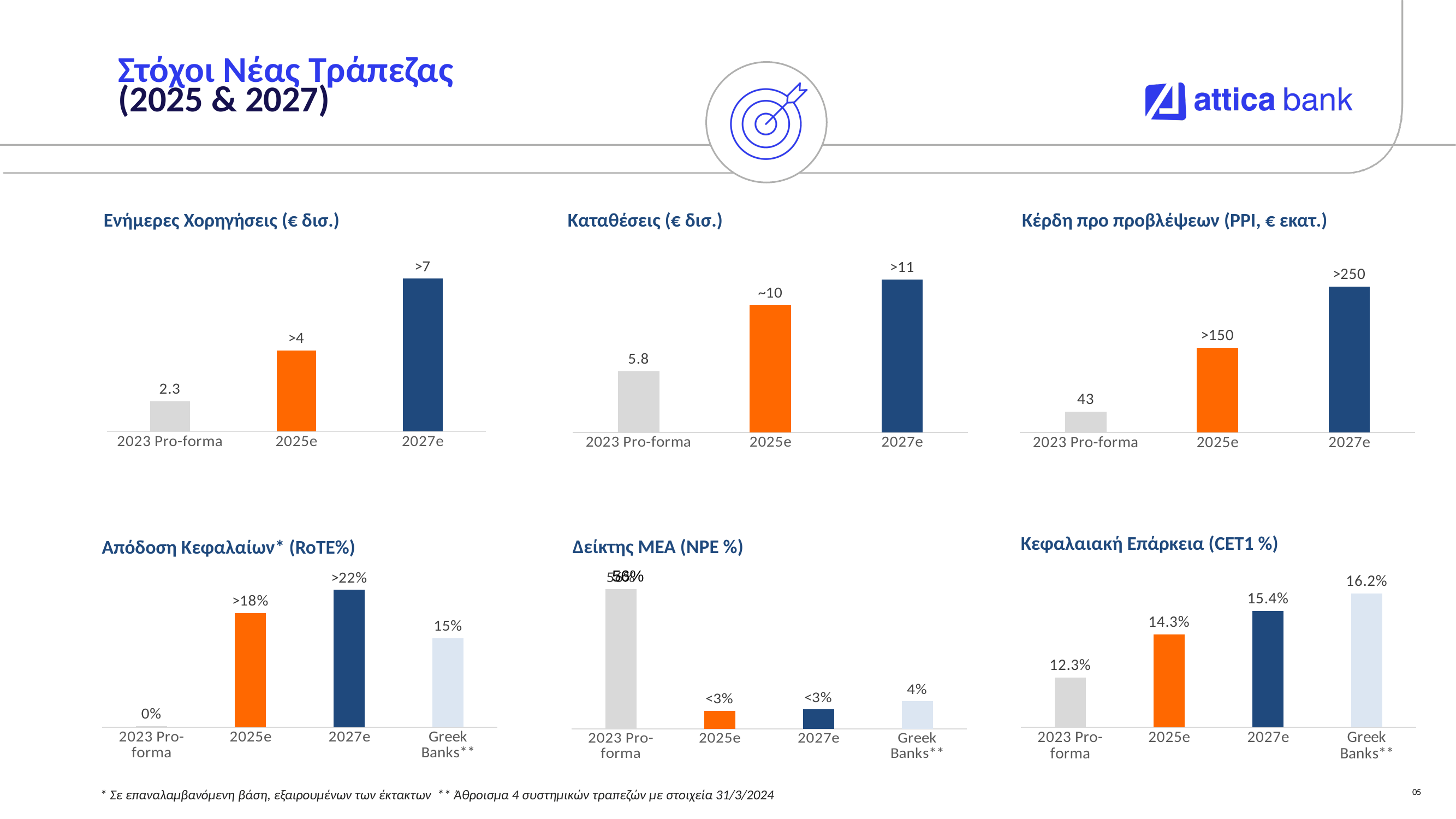
In the Κεφαλαιακή Επάρκεια (CET1 %) chart, what is the difference between Greek Banks** and 2023 Pro-forma? 3.9 percentage points In the Ενήμερες Χορηγήσεις (€ δισ.) chart, what is the value for 2023 Pro-forma? 2.3 In the Απόδοση Κεφαλαίων* (RoTE%) chart, which category has the lowest value? 2023 Pro-forma How many categories does the Κεφαλαιακή Επάρκεια (CET1 %) chart show? 4 In the Κέρδη προ προβλέψεων (PPI, € εκατ.) chart, what is the data label for 2025e? >150 In the Κεφαλαιακή Επάρκεια (CET1 %) chart, what is the value for 2027e? 15.4% In the Δείκτης ΜΕΑ (NPE %) chart, what is the value for Greek Banks**? 4% In the Καταθέσεις (€ δισ.) chart, what is the value for 2023 Pro-forma? 5.8 In the Ενήμερες Χορηγήσεις (€ δισ.) chart, what is the data label for 2027e? >7 In the Απόδοση Κεφαλαίων* (RoTE%) chart, what is the value for Greek Banks**? 15% In the Καταθέσεις (€ δισ.) chart, which category has the highest bar? 2027e In the Κέρδη προ προβλέψεων (PPI, € εκατ.) chart, what is the value for 2023 Pro-forma? 43